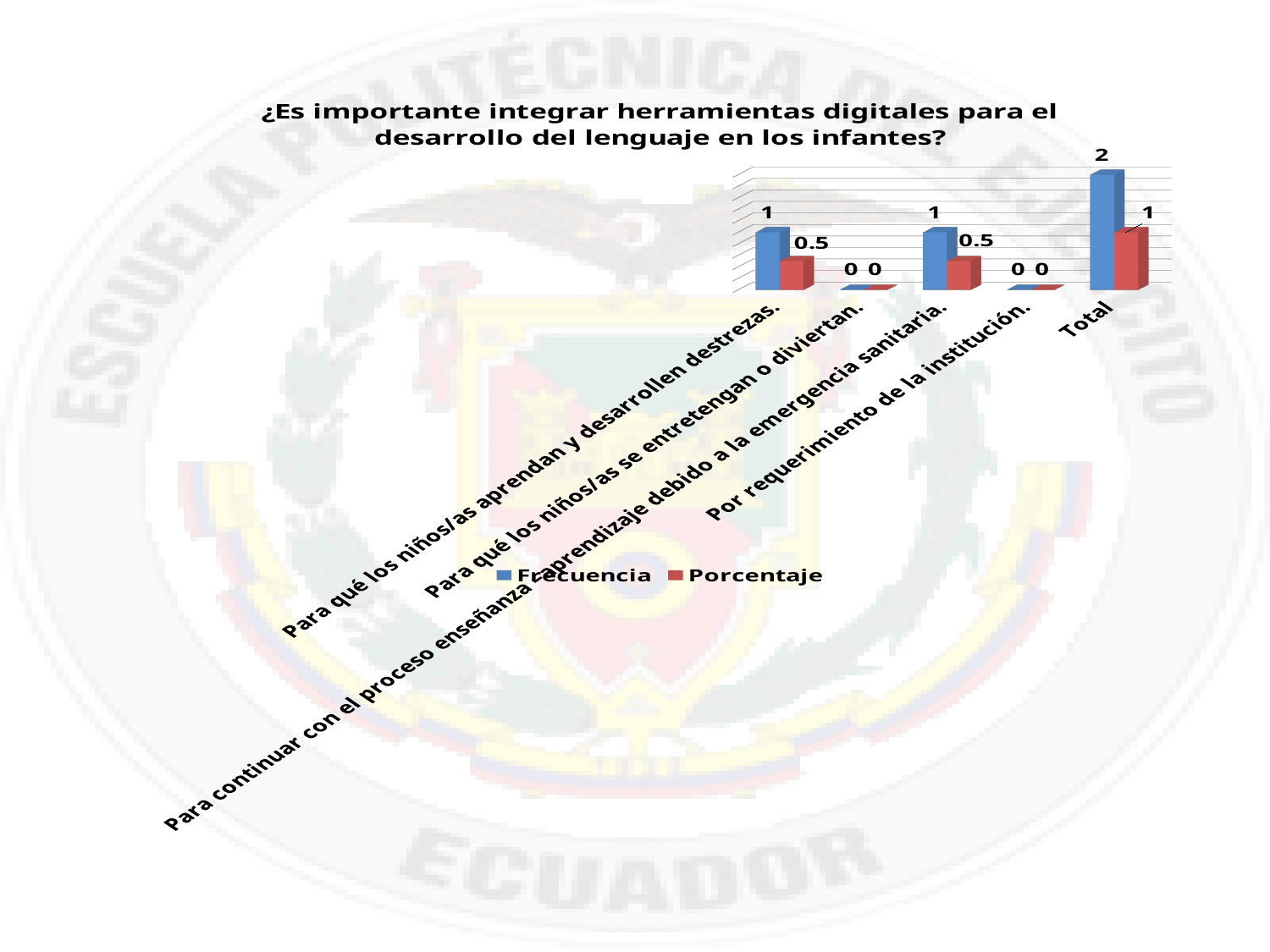
What is the Porcentaje value for "Para continuar con el proceso enseñanza aprendizaje debido a la emergencia sanitaria."? 0.5 What is the Porcentaje value for "Para qué los niños/as aprendan y desarrollen destrezas."? 0.5 What is the Frecuencia value for "Total"? 2 How many series does the legend list? 2 Which category has the highest Frecuencia value? Total What kind of chart is shown on the slide? Bar chart What is the Frecuencia value for "Para qué los niños/as se entretengan o diviertan."? 0 Which is larger: the Frecuencia value for "Para continuar con el proceso enseñanza aprendizaje debido a la emergencia sanitaria." or the Frecuencia value for "Por requerimiento de la institución."? Para continuar con el proceso enseñanza aprendizaje debido a la emergencia sanitaria. What is the Frecuencia value for "Para qué los niños/as aprendan y desarrollen destrezas."? 1 What is the Porcentaje value for "Por requerimiento de la institución."? 0 What is the difference between the Frecuencia value for "Total" and the Frecuencia value for "Para qué los niños/as aprendan y desarrollen destrezas."? 1 How many categories are shown on the x axis of the chart? 5